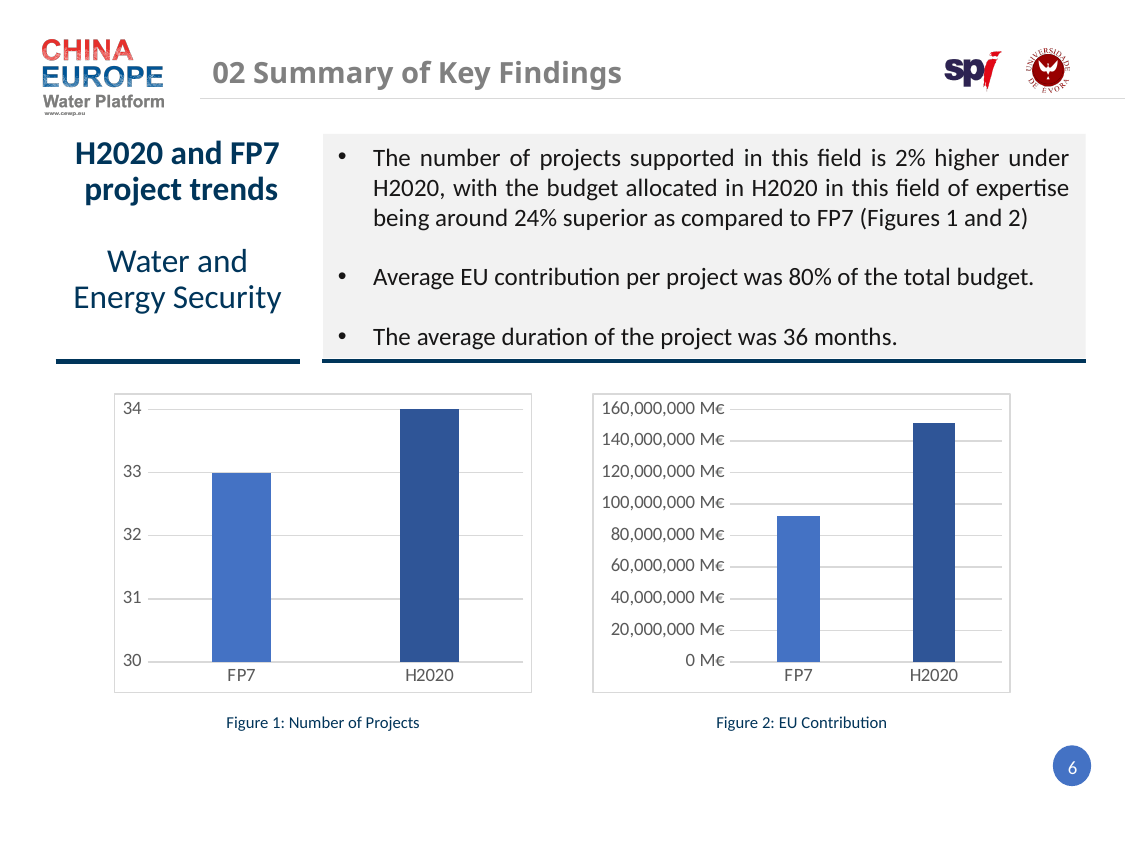
In Figure 2: EU Contribution, is the value for H2020 greater or less than 140,000,000 M€? greater In Figure 1: Number of Projects, what is the value for H2020? 34 In Figure 2: EU Contribution, is the value for FP7 larger or smaller than the value for H2020? smaller In Figure 1: Number of Projects, which category has the higher value? H2020 In Figure 1: Number of Projects, what is the value for FP7? 33 In Figure 2: EU Contribution, which category has the lower value? FP7 What is the caption of the chart on the right of the slide? Figure 2: EU Contribution In Figure 2: EU Contribution, do the values rise or fall from FP7 to H2020? rise In Figure 2: EU Contribution, is the value for FP7 greater or less than 100,000,000 M€? less In Figure 1: Number of Projects, how many categories are shown on the x axis? 2 What kind of chart is Figure 1: Number of Projects? Bar chart In Figure 1: Number of Projects, what is the difference between the H2020 and FP7 values? 1